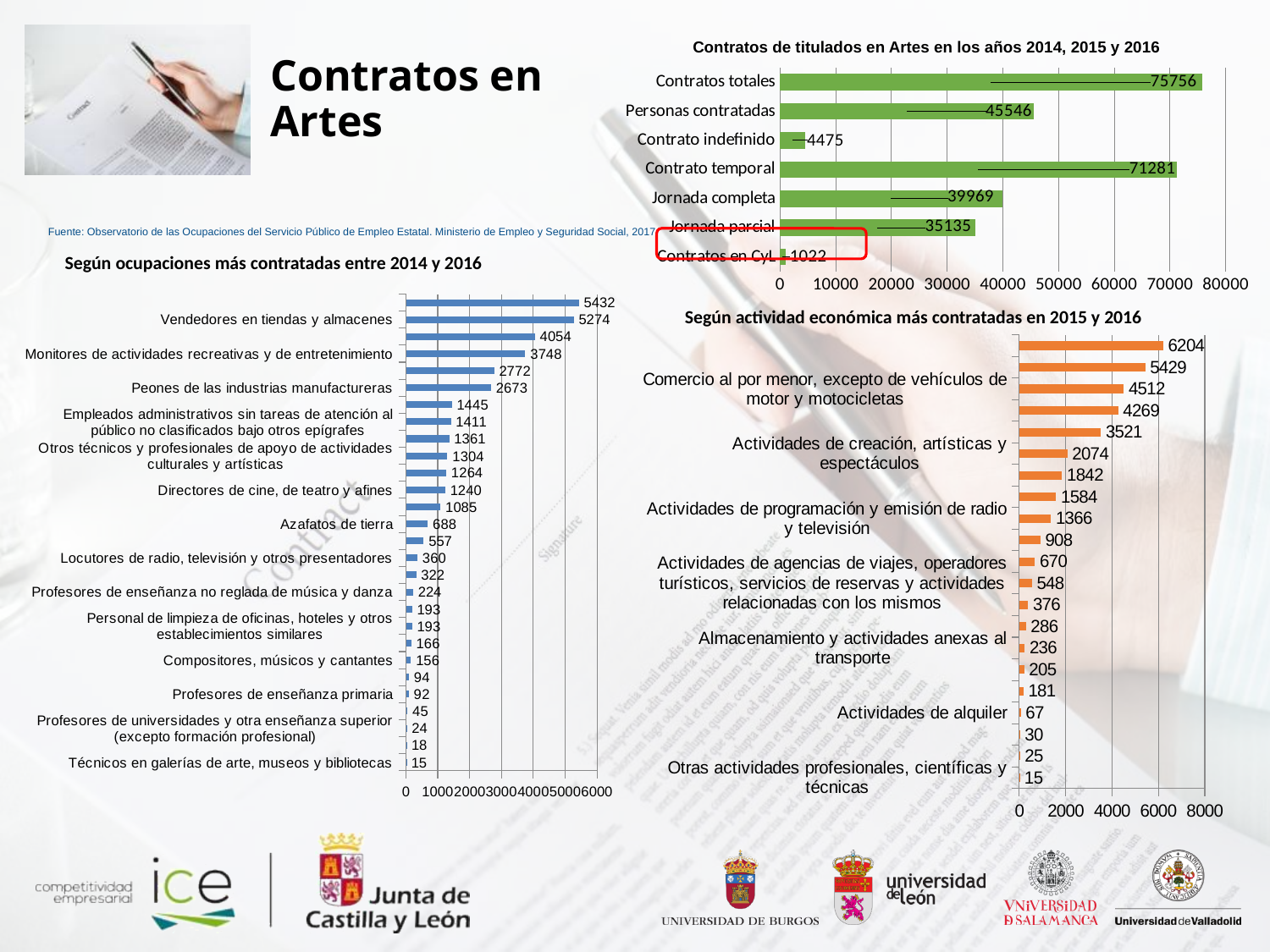
In the chart 'Contratos de titulados en Artes en los años 2014, 2015 y 2016', what is the value for Contrato indefinido? 4475 In the chart 'Contratos de titulados en Artes en los años 2014, 2015 y 2016', what is the difference between Contrato temporal and Contrato indefinido? 66806 In the chart 'Según actividad económica más contratadas en 2015 y 2016', what is the highest value shown? 6204 What kind of chart is 'Contratos de titulados en Artes en los años 2014, 2015 y 2016'? bar chart In the chart 'Contratos de titulados en Artes en los años 2014, 2015 y 2016', how many categories are shown? 7 In the chart 'Según actividad económica más contratadas en 2015 y 2016', what is the value for Actividades de alquiler? 67 In the chart 'Contratos de titulados en Artes en los años 2014, 2015 y 2016', what is the value for Jornada parcial? 35135 In the chart 'Contratos de titulados en Artes en los años 2014, 2015 y 2016', which category has the lowest value? Contratos en CyL In the chart 'Contratos de titulados en Artes en los años 2014, 2015 y 2016', which is larger: Jornada completa or Jornada parcial? Jornada completa In the chart 'Según ocupaciones más contratadas entre 2014 y 2016', what is the highest value shown? 5432 In the chart 'Contratos de titulados en Artes en los años 2014, 2015 y 2016', what is the value for Contratos totales? 75756 In the chart 'Según ocupaciones más contratadas entre 2014 y 2016', what is the value for Técnicos en galerías de arte, museos y bibliotecas? 15